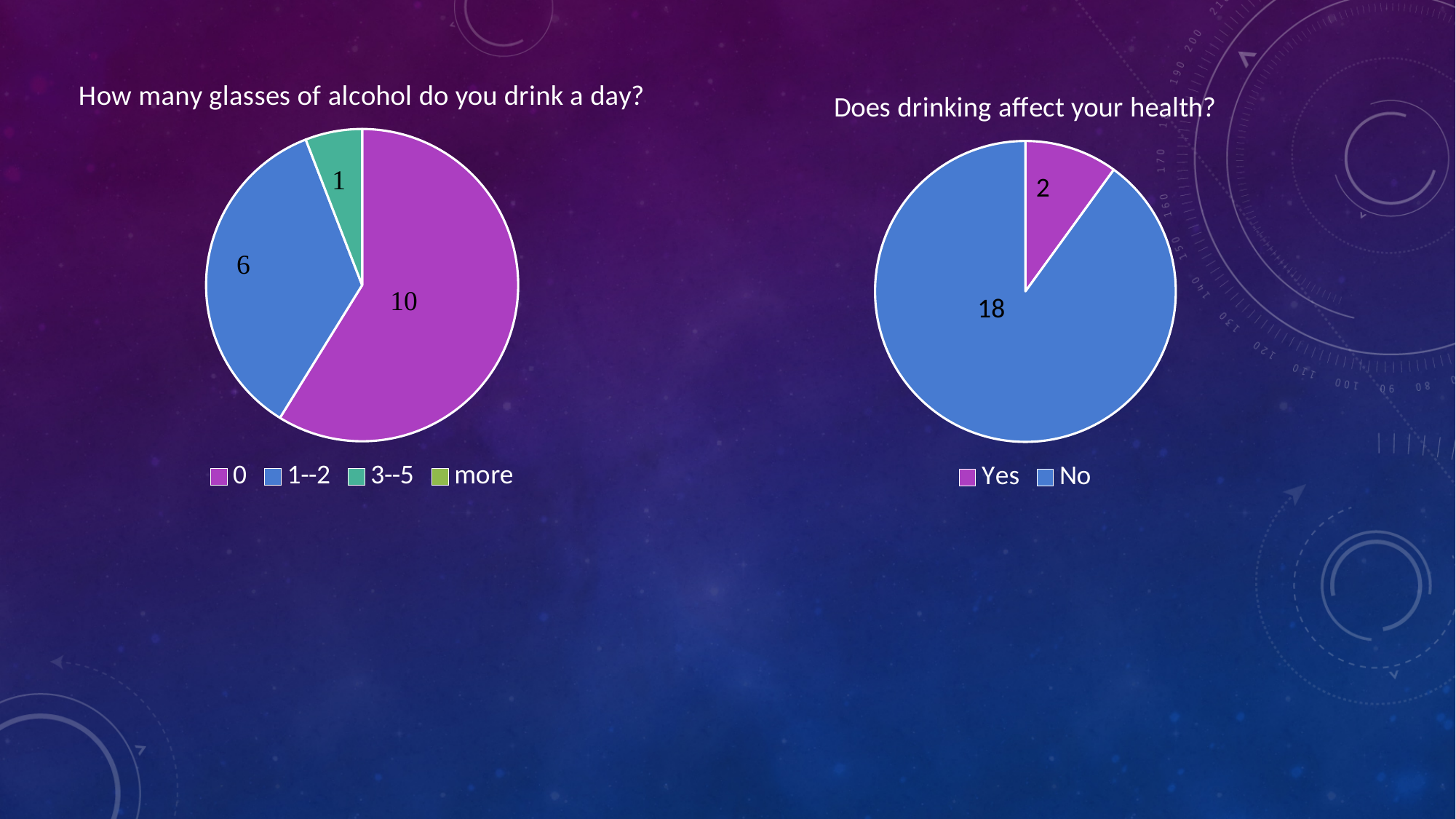
In the chart titled "Does drinking affect your health?", what is the value for "No"? 18 In the chart titled "How many glasses of alcohol do you drink a day?", what is the value for the "0" category? 10 In the chart titled "How many glasses of alcohol do you drink a day?", which category has the largest slice? 0 What type of chart is the chart on the right of the slide? Pie chart In the chart titled "How many glasses of alcohol do you drink a day?", what is the difference between the "0" and "1--2" values? 4 In the chart titled "Does drinking affect your health?", which category has the smallest slice? Yes In the chart titled "How many glasses of alcohol do you drink a day?", what is the value for the "1--2" category? 6 In the chart titled "Does drinking affect your health?", what is the value for "Yes"? 2 In the chart titled "Does drinking affect your health?", what is the difference between the "No" and "Yes" values? 16 In the chart titled "How many glasses of alcohol do you drink a day?", what is the value for the "3--5" category? 1 In the chart titled "How many glasses of alcohol do you drink a day?", how many categories does the legend list? 4 In the chart titled "Does drinking affect your health?", what share of the pie does "No" represent? 90%